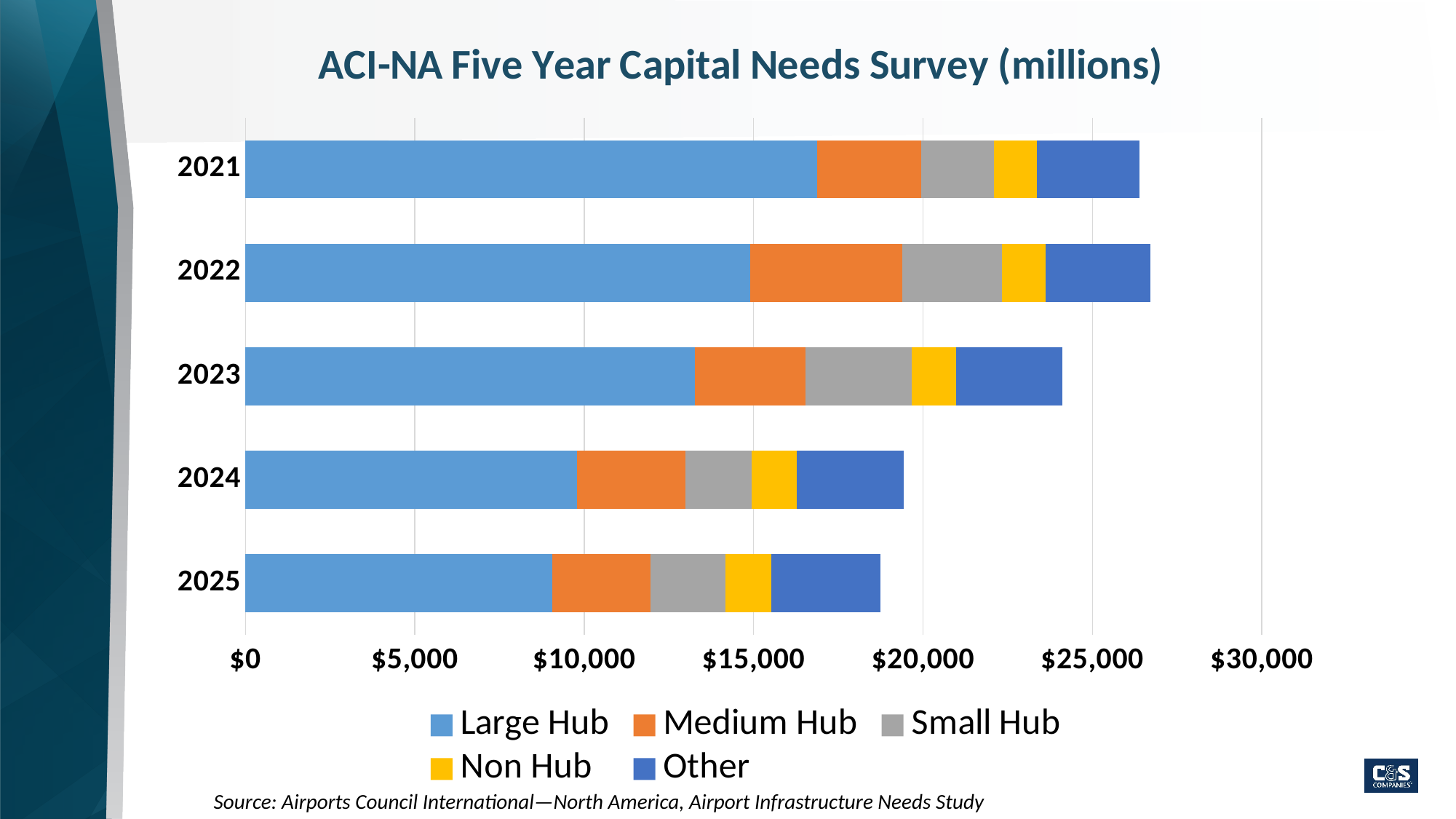
Is the total bar for 2025 greater or less than $20,000? less Which series is shown in orange in the legend? Medium Hub Is the total bar for 2021 greater or less than $25,000? greater What is the title of the chart? ACI-NA Five Year Capital Needs Survey (millions) Is the Large Hub value for 2021 greater or less than $15,000? greater Which year has the largest Large Hub segment? 2021 Which year has the shortest total bar? 2025 Which is larger, the Medium Hub segment for 2022 or for 2025? 2022 How many years are shown on the chart? 5 What kind of chart is shown on the slide? Stacked bar chart How many series does the legend list? 5